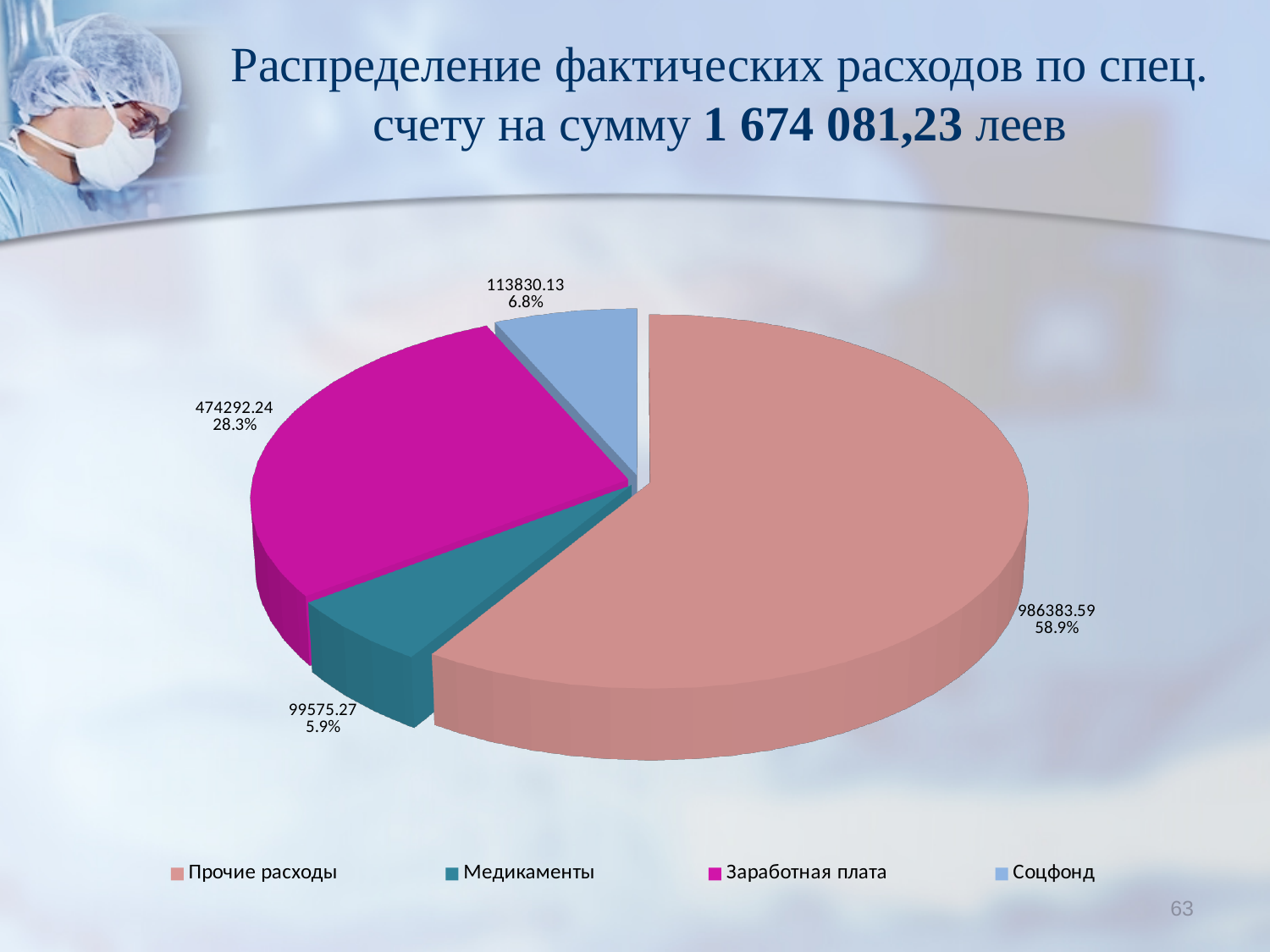
Which category has the smallest slice of the pie? Медикаменты What kind of chart is shown on the slide? Pie chart Which is larger, Заработная плата or Соцфонд? Заработная плата What value is shown for Соцфонд? 113830.13 What percentage share does Соцфонд have? 6.8% Which category has the largest slice of the pie? Прочие расходы What percentage share does Заработная плата have? 28.3% What is the difference in percentage points between Соцфонд (6.8%) and Медикаменты (5.9%)? 0.9 How many slices does the pie chart have? 4 What value is shown for Прочие расходы? 986383.59 What value is shown for Медикаменты? 99575.27 What total amount is stated in the chart title? 1 674 081,23 леев